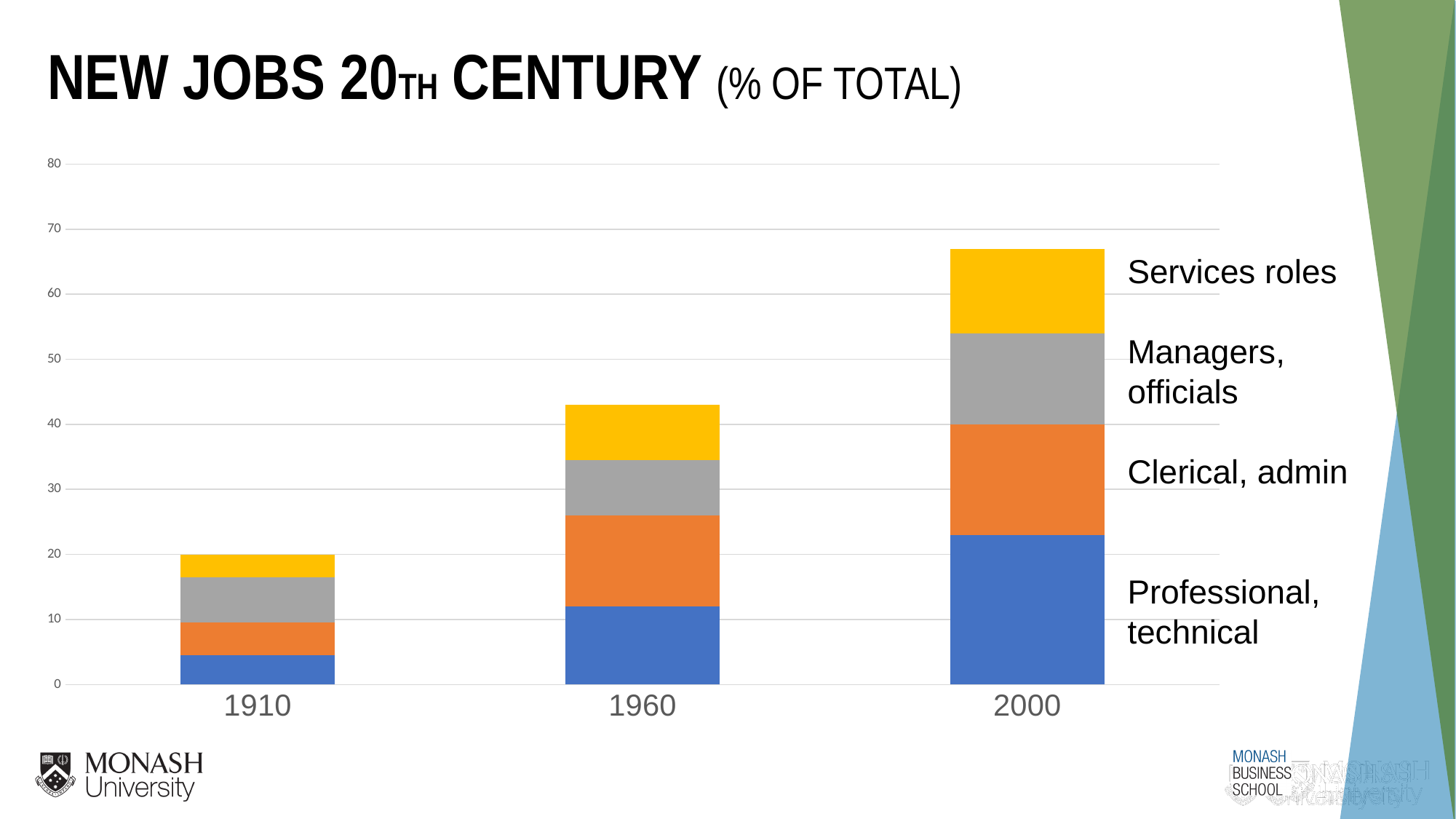
What is the title of the chart? NEW JOBS 20TH CENTURY (% OF TOTAL) How many years (categories) are shown on the x axis? 3 Which year has the lowest total bar? 1910 Is the total bar for 1910 greater or less than 30? less How many job categories (series) does the chart's legend list? 4 Do the total bar heights rise or fall from 1910 to 2000? rise What kind of chart is shown on the slide? bar chart Which year has the larger total bar, 1910 or 1960? 1960 Is the total bar for 1960 greater or less than 40? greater Is the Professional, technical segment for 2000 greater or less than 20? greater Which year has the highest total bar? 2000